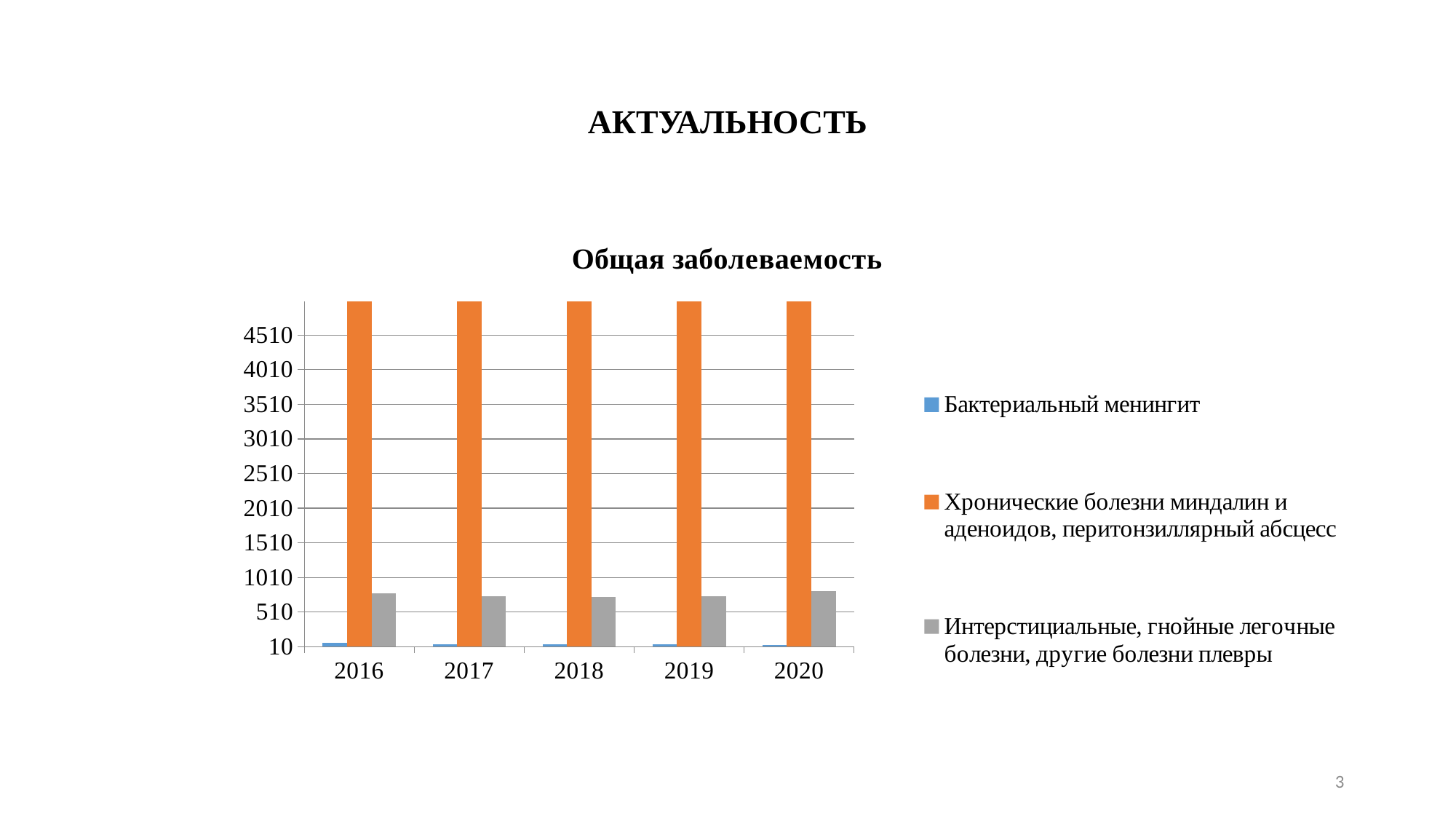
Is the value for Бактериальный менингит in 2019 greater or less than 510? less Is the value for Интерстициальные, гнойные легочные болезни, другие болезни плевры in 2020 greater or less than 510? greater What type of chart is shown on the slide? bar chart What is the title of the chart? Общая заболеваемость Which series has the highest bar in every year? Хронические болезни миндалин и аденоидов, перитонзиллярный абсцесс Which colour represents Бактериальный менингит in the legend? blue In which year is the bar for Интерстициальные, гнойные легочные болезни, другие болезни плевры the highest? 2020 Is the value for Хронические болезни миндалин и аденоидов, перитонзиллярный абсцесс in 2018 greater or less than 4510? greater How many years are shown on the x axis? 5 How many series does the legend list? 3 Which series has the lowest bar in every year? Бактериальный менингит